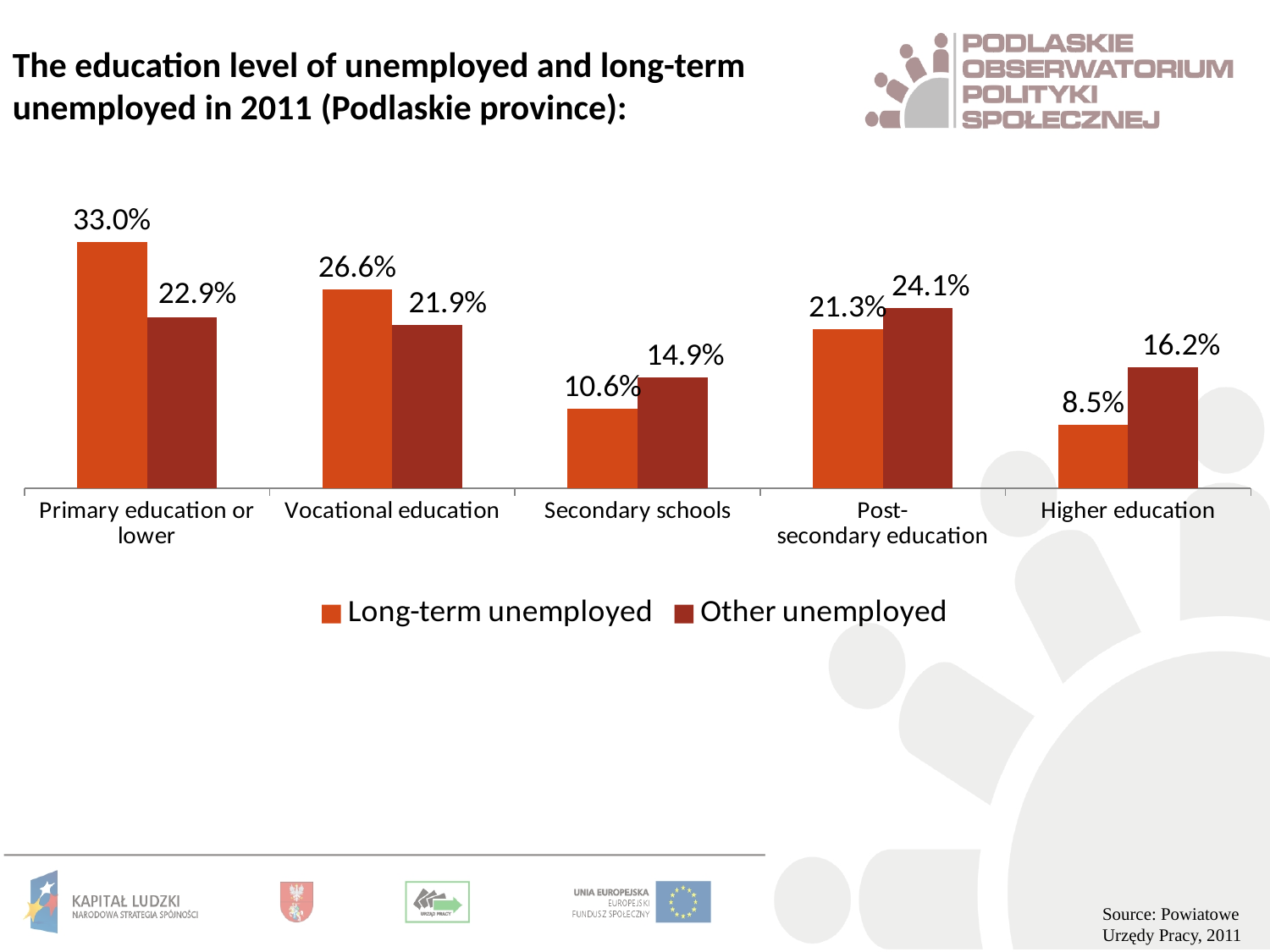
How many education categories are shown on the x axis? 5 Which category has the highest value for Long-term unemployed? Primary education or lower Which category has the lowest value for Other unemployed? Secondary schools What is the difference between Long-term unemployed and Other unemployed in the Vocational education category? 4.7% What kind of chart is shown on the slide? Bar chart What are the two series listed in the legend? Long-term unemployed and Other unemployed What is the value for Long-term unemployed in the Primary education or lower category? 33.0% How many series does the legend list? 2 In the Post-secondary education category, which series has the larger value, Long-term unemployed or Other unemployed? Other unemployed What is the difference between Long-term unemployed and Other unemployed in the Higher education category? 7.7% What is the value for Other unemployed in the Higher education category? 16.2% What is the value for Long-term unemployed in the Secondary schools category? 10.6%